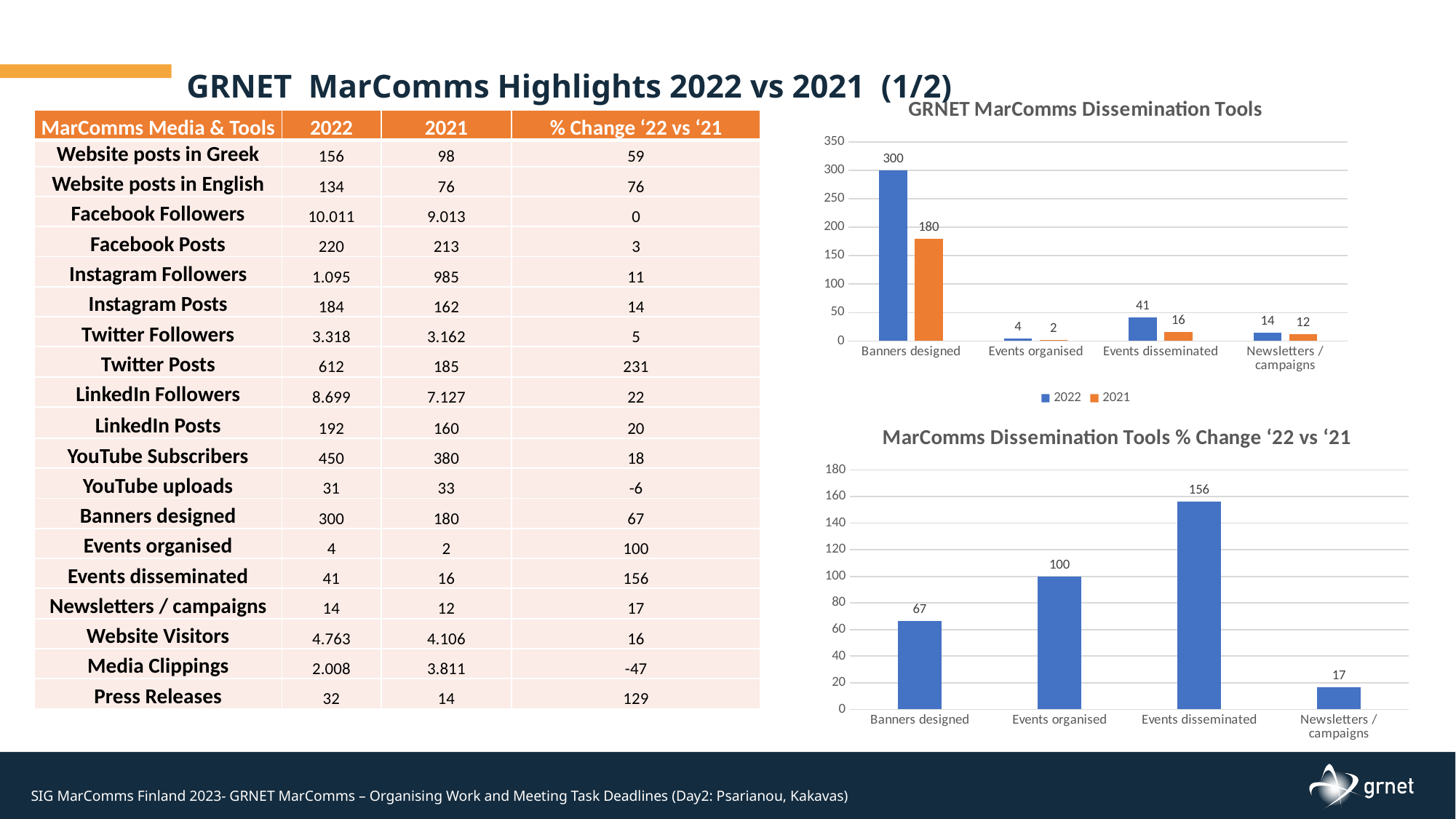
In the 'GRNET MarComms Dissemination Tools' chart, what is the 2021 value for Events disseminated? 16 In the 'GRNET MarComms Dissemination Tools' chart, which colour represents 2021? Orange In the 'MarComms Dissemination Tools % Change ‘22 vs ‘21' chart, which category has the lowest value? Newsletters / campaigns In the 'GRNET MarComms Dissemination Tools' chart, which category has the highest 2022 value? Banners designed In the 'GRNET MarComms Dissemination Tools' chart, how many series does the legend list? 2 In the 'GRNET MarComms Dissemination Tools' chart, which category has the lowest 2021 value? Events organised What type of chart is the 'MarComms Dissemination Tools % Change ‘22 vs ‘21' chart? Bar chart In the 'MarComms Dissemination Tools % Change ‘22 vs ‘21' chart, which category has the highest value? Events disseminated In the 'MarComms Dissemination Tools % Change ‘22 vs ‘21' chart, what is the value for Events organised? 100 In the 'GRNET MarComms Dissemination Tools' chart, what is the difference between the 2022 and 2021 values for Banners designed? 120 In the 'MarComms Dissemination Tools % Change ‘22 vs ‘21' chart, how many categories are shown on the x axis? 4 In the 'GRNET MarComms Dissemination Tools' chart, what is the 2022 value for Banners designed? 300